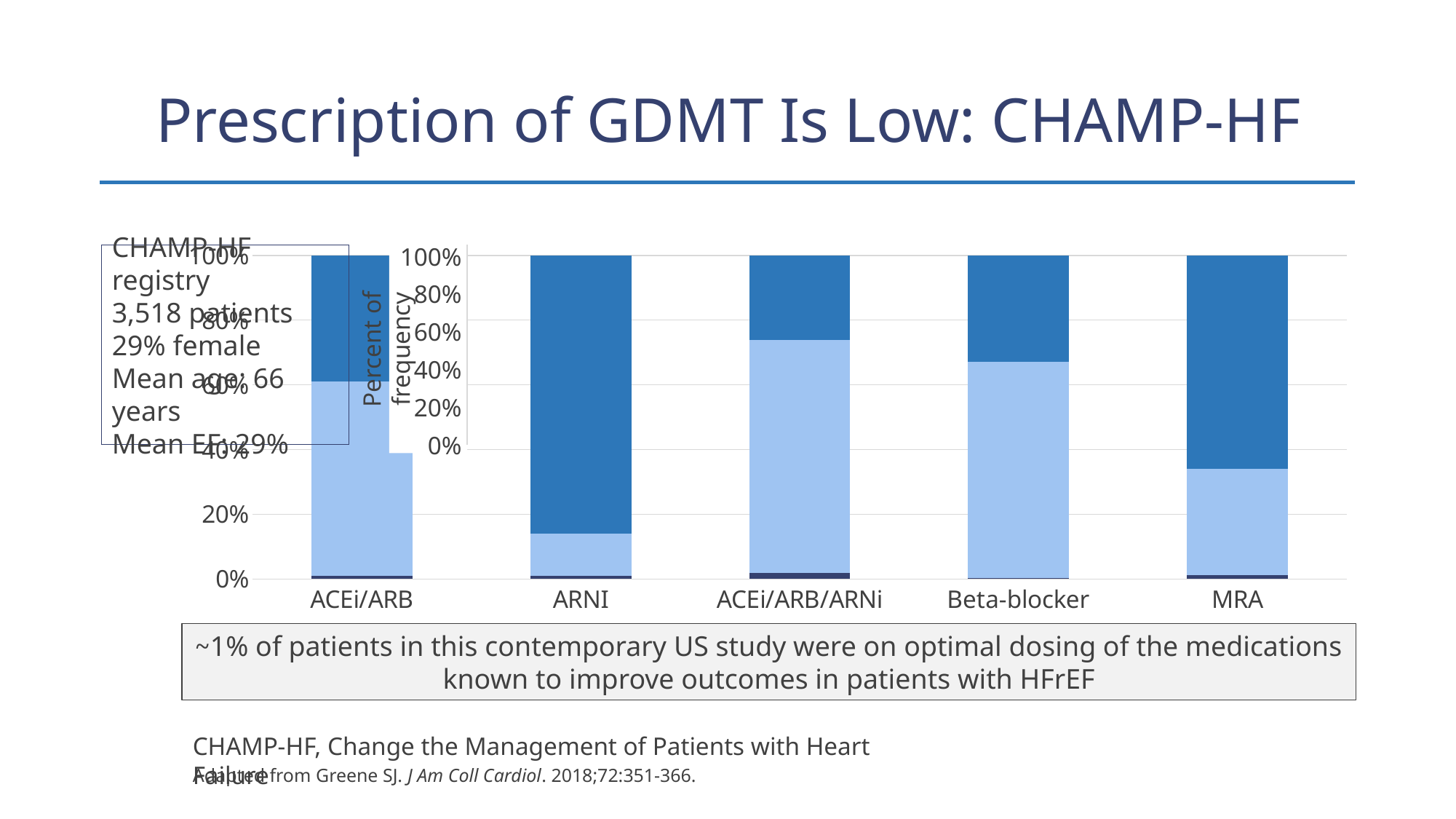
How many medication categories are shown on the x axis of the chart? 5 What kind of chart is shown on the slide? Stacked bar chart Is the top of the light blue segment for ACEi/ARB greater or less than 40%? greater Which has a larger light blue segment, Beta-blocker or MRA? Beta-blocker What is the label of the y axis of the chart? Percent of frequency Is the top of the light blue segment for MRA greater or less than 40%? less Is the top of the light blue segment for ARNI greater or less than 20%? less What is the total height of the ARNI stacked bar? 100% Which category has the smallest light blue segment? ARNI Which category is the first bar on the left of the chart? ACEi/ARB Which category has the largest light blue segment? ACEi/ARB/ARNi Which category has the largest dark blue (top) segment? ARNI